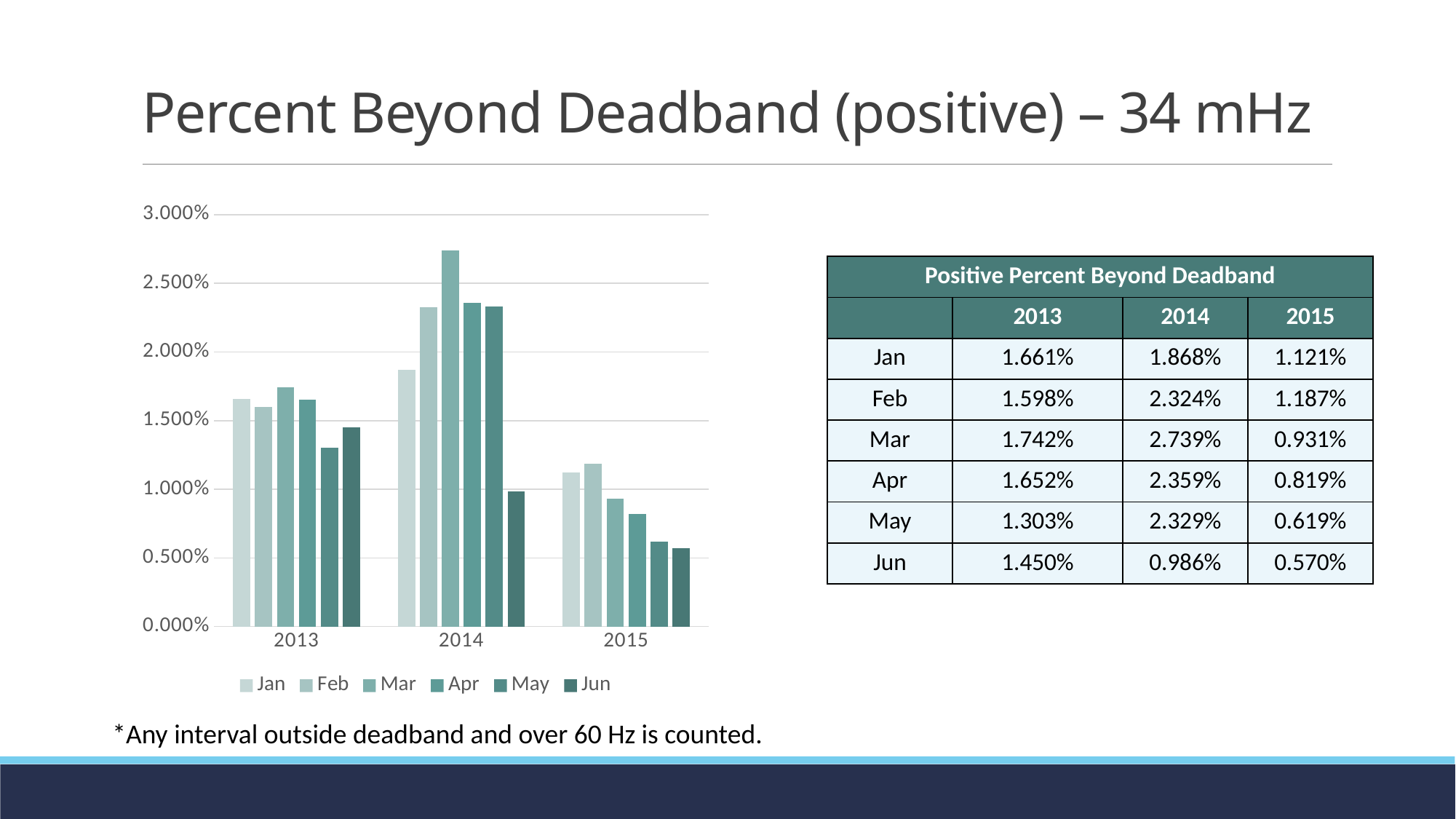
Which is larger, the value for Jan in 2013 or the value for Jan in 2015? Jan in 2013 What kind of chart is shown on the slide? bar chart How many year categories are shown on the x axis of the chart? 3 How many series does the chart legend list? 6 Is the value for Mar in 2014 greater or less than 2.500%? greater What is the value for May in 2013? 1.303% What is the value for Jun in 2015? 0.570% What is the difference between the Feb value in 2014 and the Feb value in 2015? 1.137% What is the value for Mar in 2014? 2.739% Which month has the highest value in 2014? Mar Do the values for Jun rise or fall from 2013 to 2015? fall Which month has the lowest value in 2015? Jun